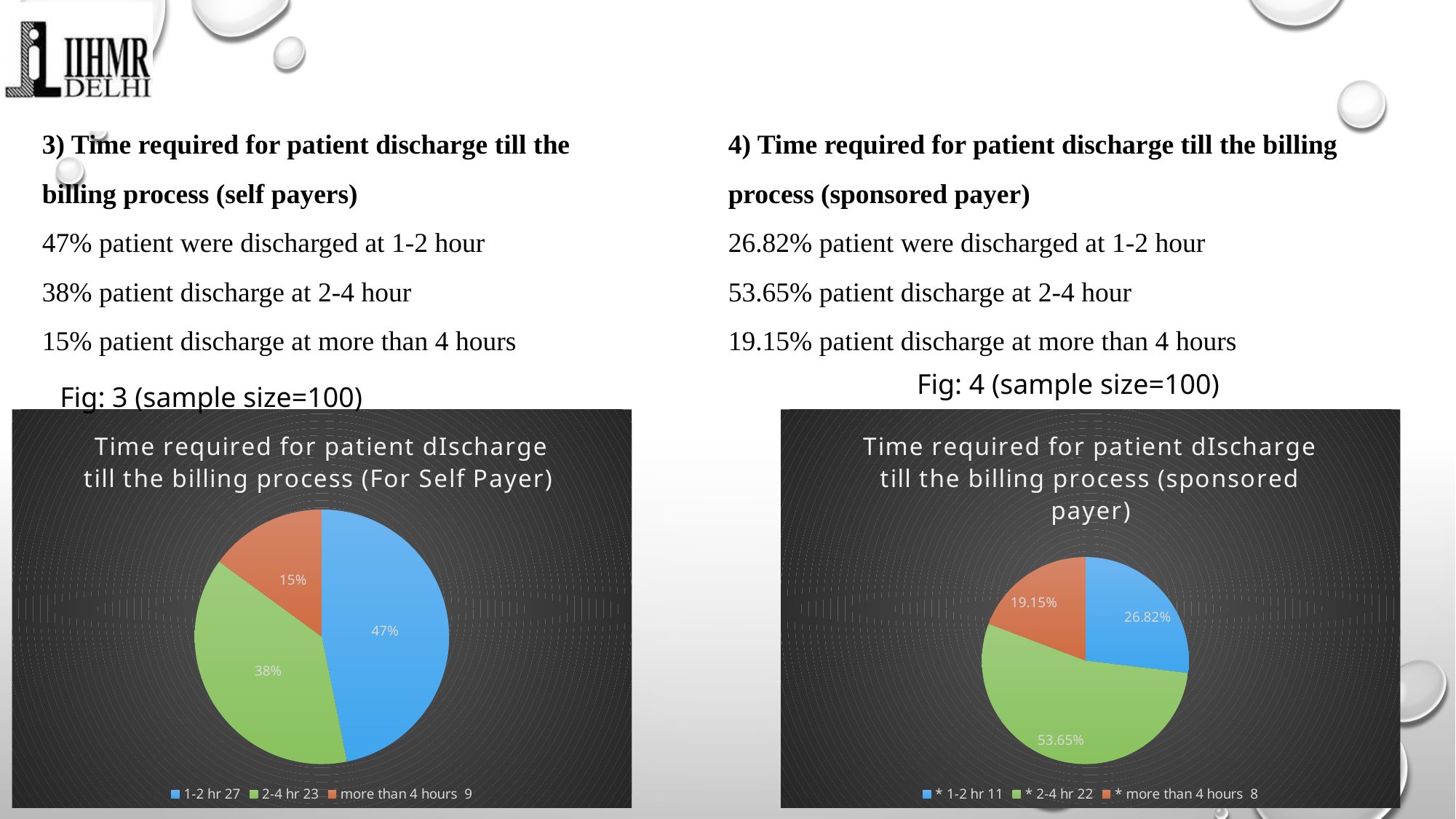
In the left chart (For Self Payer), what percentage is shown for the 1-2 hr slice? 47% In the left chart (For Self Payer), which category has the largest slice? 1-2 hr What type of chart is the left chart (For Self Payer)? pie chart In the right chart (sponsored payer), what percentage is shown for the 2-4 hr slice? 53.65% How many slices does the right chart (sponsored payer) have? 3 In the right chart (sponsored payer), which category has the smallest slice? more than 4 hours In the left chart (For Self Payer), what colour is the 2-4 hr slice? green In the left chart (For Self Payer), what percentage is shown for the more than 4 hours slice? 15% In the right chart (sponsored payer), what percentage is shown for the 1-2 hr slice? 26.82% In the left chart (For Self Payer), what is the difference between the 1-2 hr and 2-4 hr slices? 9% In the left chart (For Self Payer), what percentage is shown for the 2-4 hr slice? 38% In the right chart (sponsored payer), which slice is larger: 1-2 hr or more than 4 hours? 1-2 hr